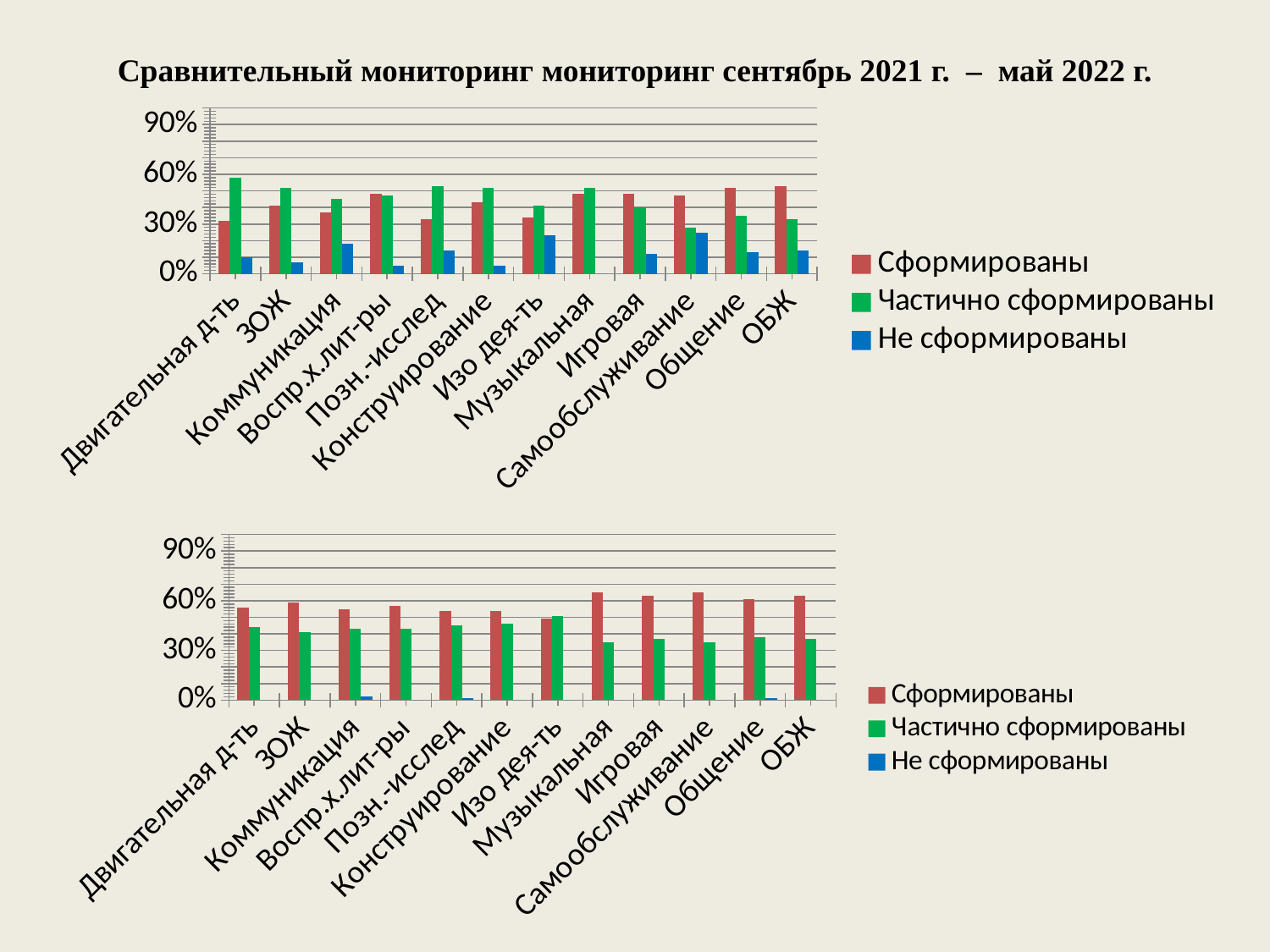
In the bottom chart, is the value of Сформированы for Изо дея-ть greater or less than 60%? less In the top chart, for Двигательная д-ть, which is larger: Сформированы or Частично сформированы? Частично сформированы In the bottom chart, is the value of Сформированы for Музыкальная greater or less than 60%? greater How many categories are shown on the x axis of the top chart? 12 In the bottom chart, for Двигательная д-ть, which is larger: Сформированы or Частично сформированы? Сформированы In the top chart, which colour represents the series Не сформированы? blue In the bottom chart, is the value of Частично сформированы for Игровая greater or less than 30%? greater What kind of chart is the top chart on the slide? bar chart How many series does the legend of the bottom chart list? 3 What is the title shown above the charts on the slide? Сравнительный мониторинг мониторинг сентябрь 2021 г. – май 2022 г. In the top chart, which category has the highest value for Частично сформированы? Двигательная д-ть